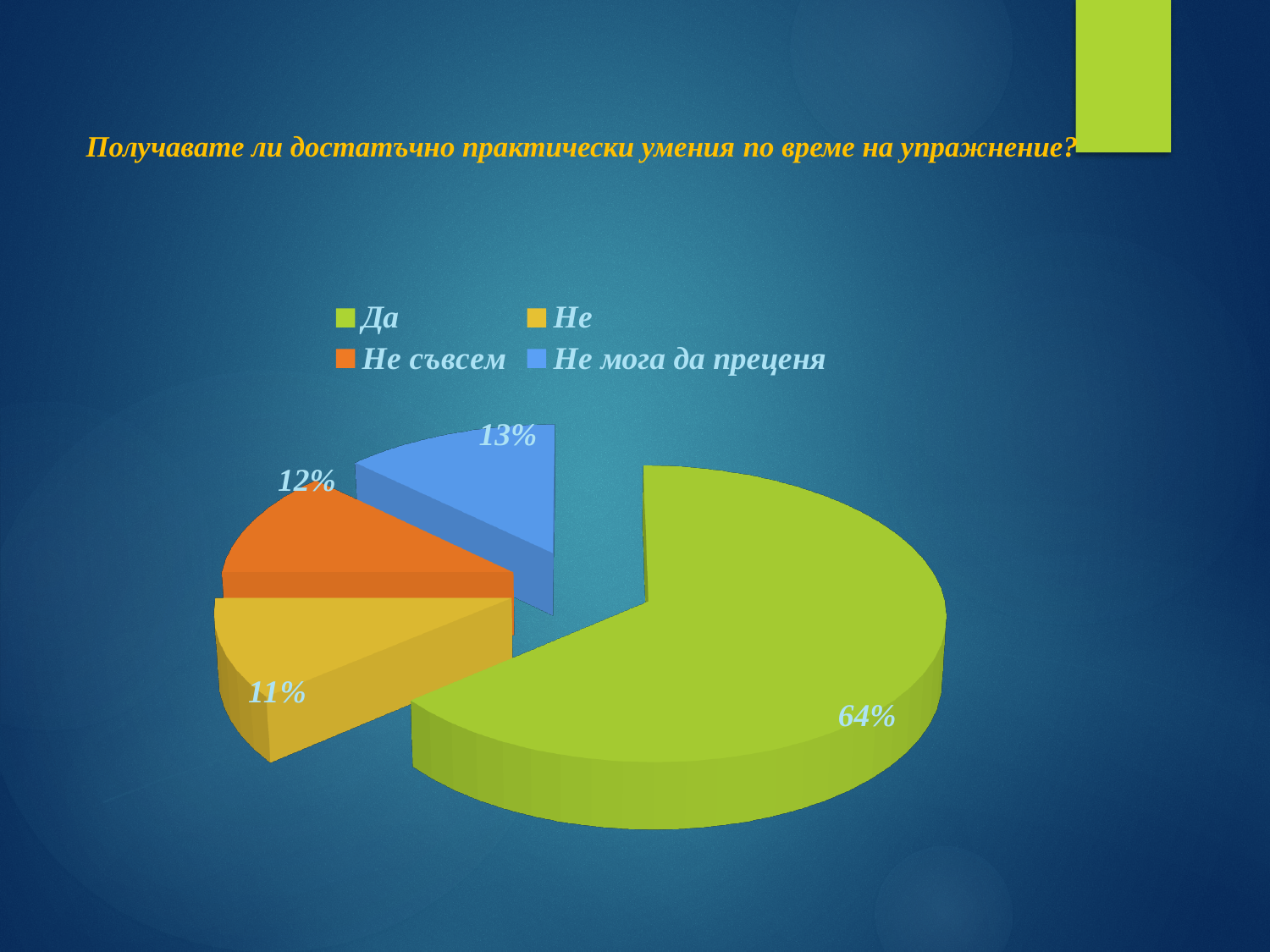
Which is larger, the slice for "Не съвсем" or the slice for "Не"? Не съвсем What share of the pie does "Не мога да преценя" have? 13% What share of the pie does "Не" have? 11% How many categories does the pie chart have? 4 What is the title of the slide above the chart? Получавате ли достатъчно практически умения по време на упражнение? What colour is the slice for "Не мога да преценя"? blue What kind of chart is shown on the slide? pie chart What share of the pie does "Да" have? 64% Which category has the smallest slice of the pie? Не What share of the pie does "Не съвсем" have? 12% What is the difference in percentage points between "Да" and "Не мога да преценя"? 51 Which category has the largest slice of the pie? Да